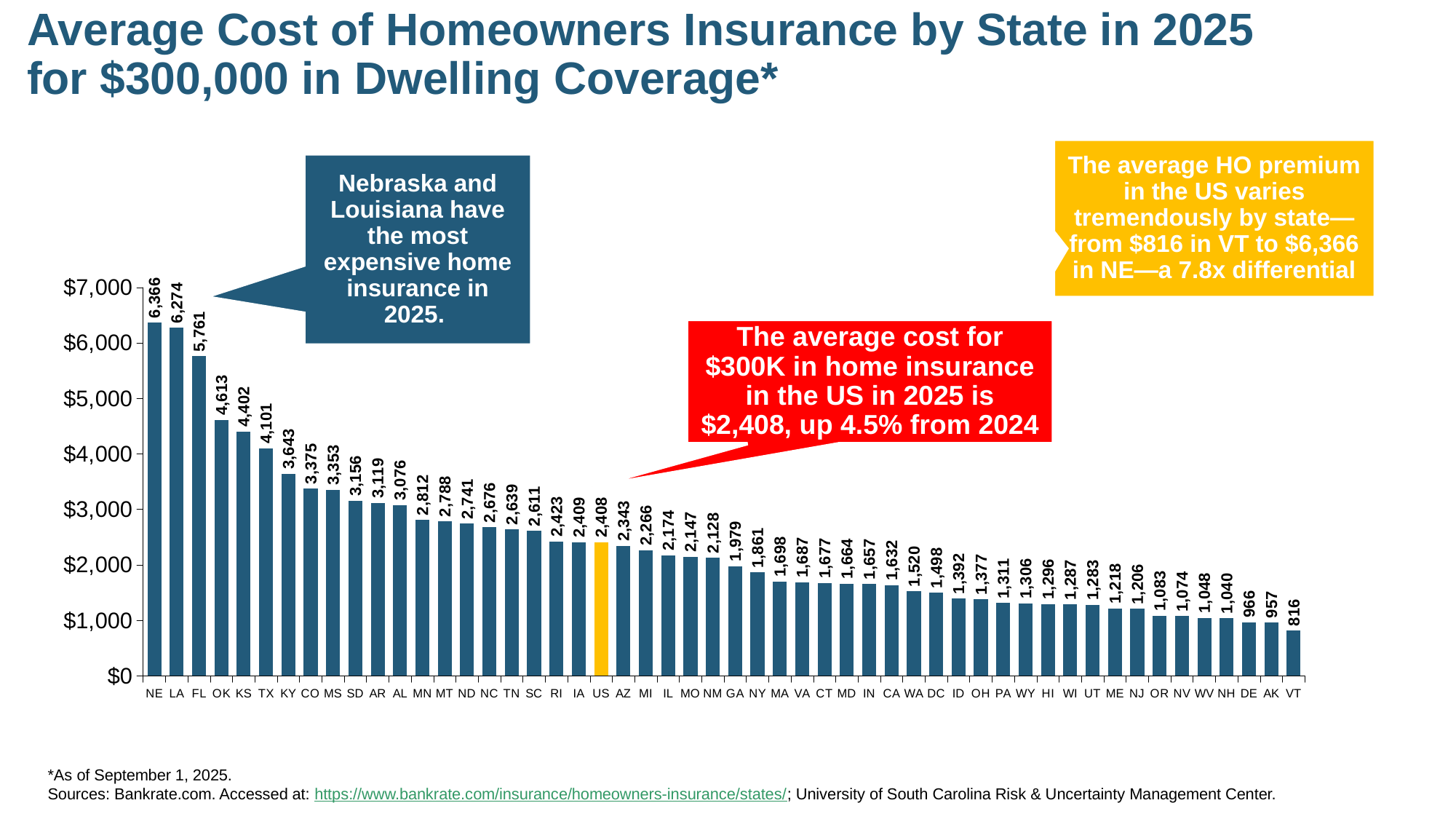
Which bar is highlighted in a different colour (yellow) from the rest? US Which state has the lowest average homeowners insurance cost on the chart? VT What is the difference between the values for LA and FL? 513 What value is shown for the US bar? 2,408 Which state has the highest average homeowners insurance cost on the chart? NE What is the difference between the values for NE and VT? 5,550 Is the value for CO greater or less than $3,000? greater How many bars are plotted on the chart? 52 What is the value shown for Texas (TX)? 4,101 What is the average cost of homeowners insurance shown for Florida (FL)? 5,761 Which has a higher value, OK or KS? OK What kind of chart is shown on the slide? Bar chart